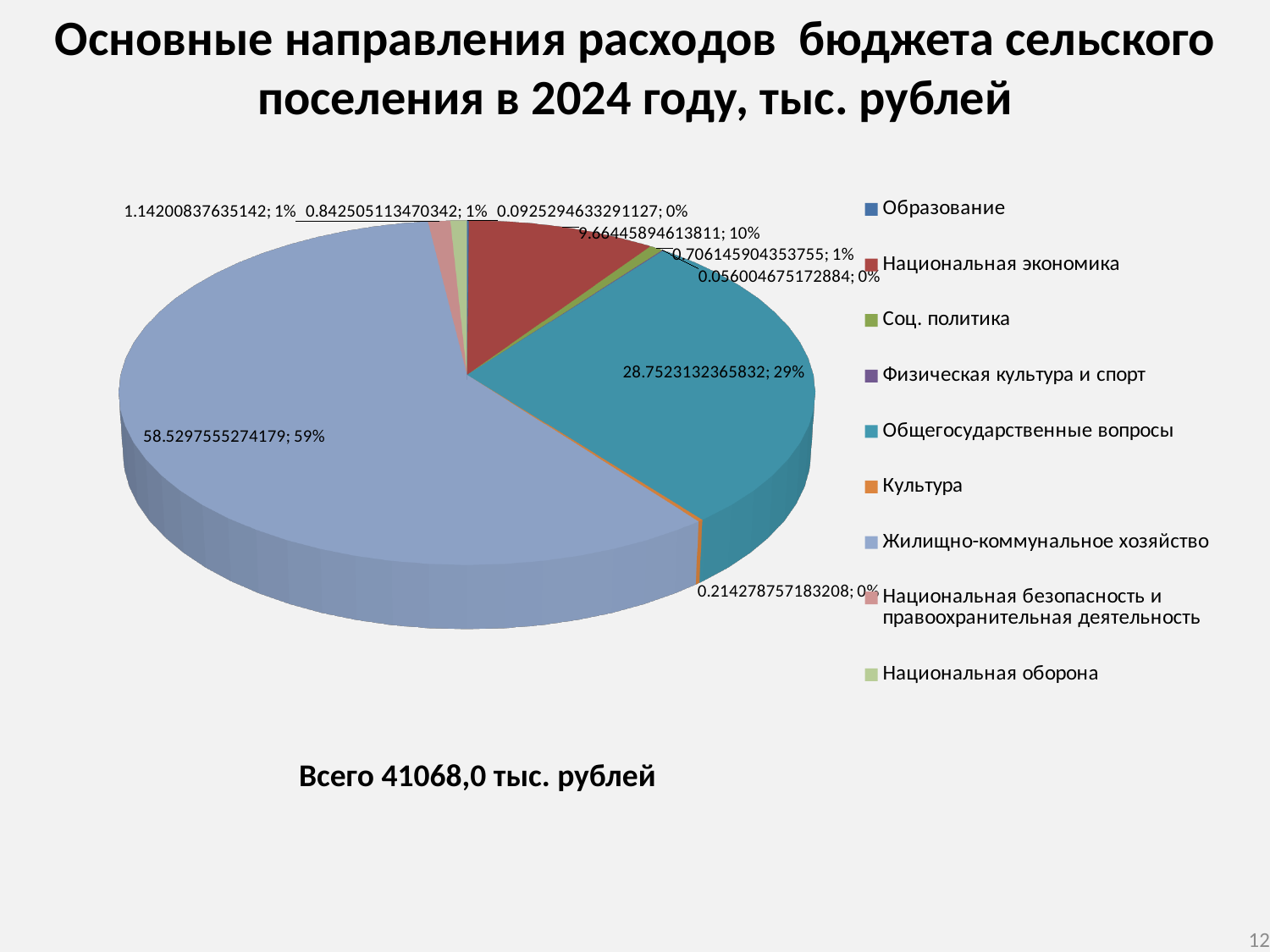
What value is labelled on the Национальная экономика slice? 9.66445894613811 How many categories does the legend of the pie chart list? 9 What percentage share does Национальная экономика have in the pie chart? 10% What is the title of the chart slide? Основные направления расходов бюджета сельского поселения в 2024 году, тыс. рублей What kind of chart is shown on the slide? pie chart Which is larger in the pie chart: Общегосударственные вопросы or Национальная экономика? Общегосударственные вопросы What value is labelled on the Жилищно-коммунальное хозяйство slice? 58.5297555274179 Which category has the largest slice of the pie chart? Жилищно-коммунальное хозяйство What value is labelled on the Общегосударственные вопросы slice? 28.7523132365832 What total amount is stated in the text below the pie chart? Всего 41068,0 тыс. рублей What percentage share does Общегосударственные вопросы have in the pie chart? 29% What percentage share does Жилищно-коммунальное хозяйство have in the pie chart? 59%